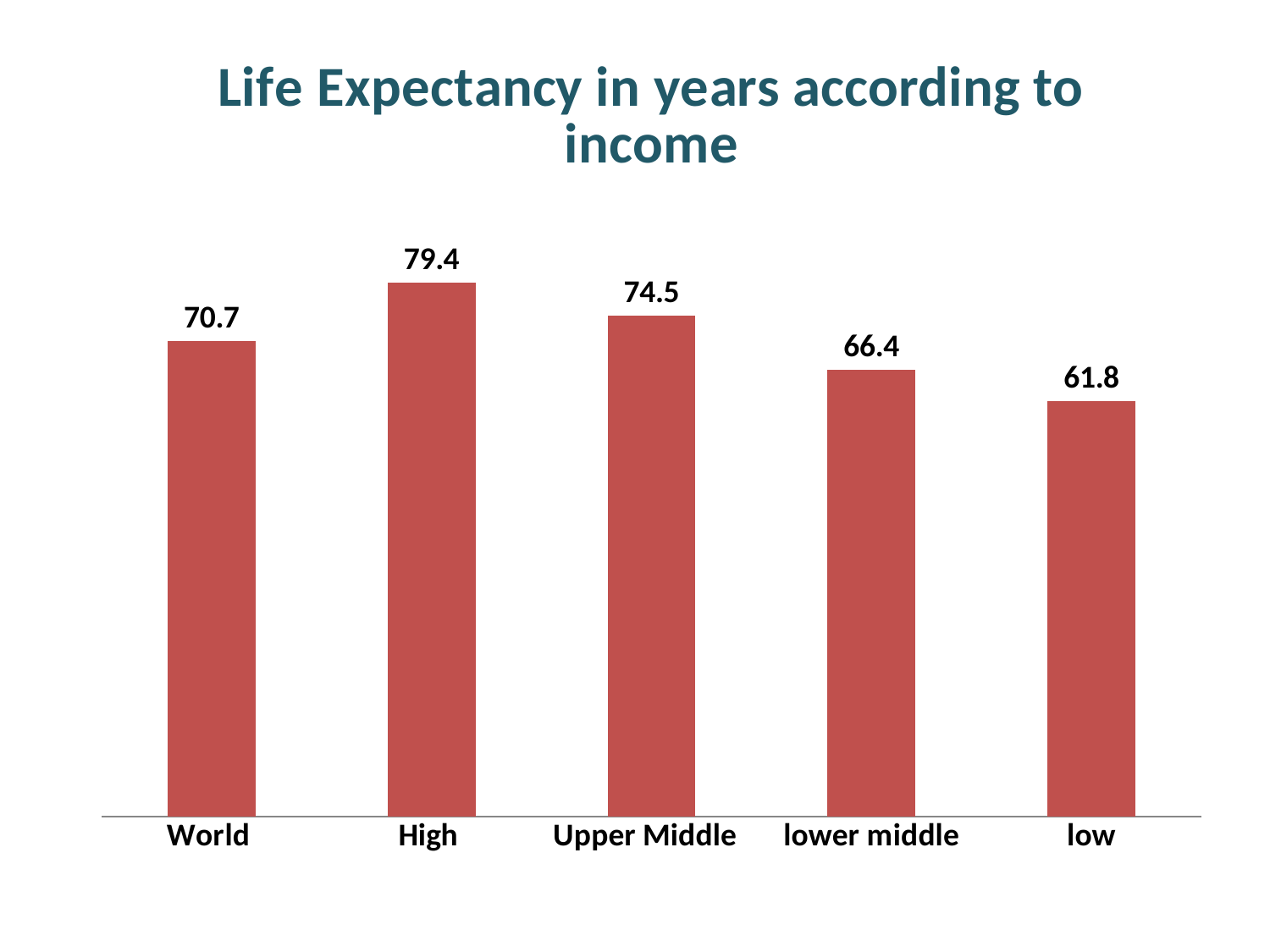
What is the life expectancy value for the World category? 70.7 Which category has the lowest life expectancy? low What is the life expectancy value for the Upper Middle income category? 74.5 What is the life expectancy value for the low income category? 61.8 Which category has the highest life expectancy? High What kind of chart is shown on the slide? Bar chart Which has a higher life expectancy, World or lower middle income? World What is the difference in life expectancy between Upper Middle and lower middle income? 8.1 How many categories are shown in the chart? 5 What is the title of the chart? Life Expectancy in years according to income What is the difference in life expectancy between the High and low income categories? 17.6 What is the life expectancy value for the High income category? 79.4